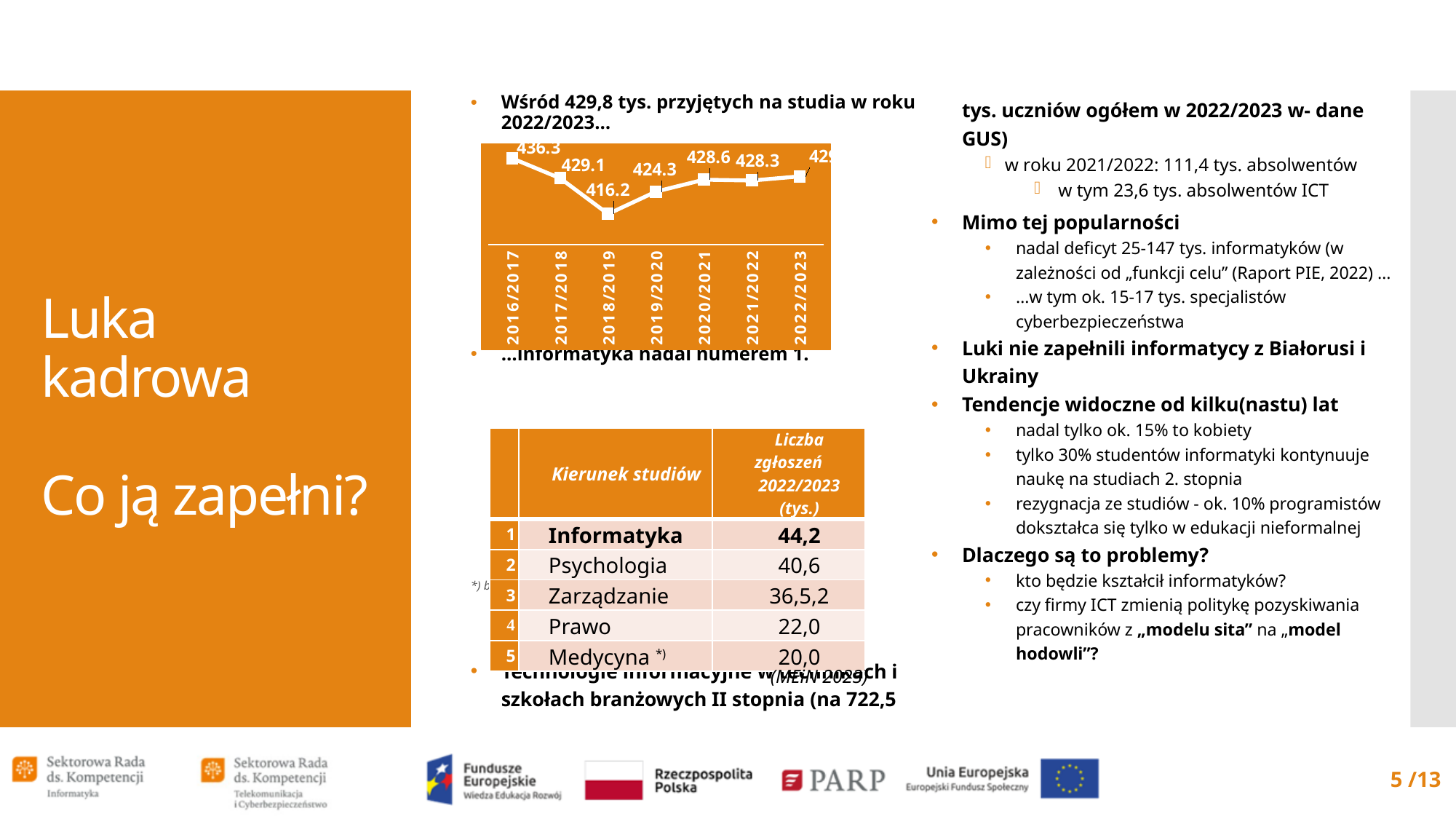
Which year has the lowest value in the line chart? 2018/2019 Do the values in the line chart rise or fall from 2016/2017 to 2018/2019? fall How many academic years are plotted on the x axis of the line chart? 7 What is the value for 2016/2017 in the line chart? 436.3 What is the difference between the values for 2017/2018 and 2019/2020 in the line chart? 4.8 Which is larger in the line chart: the value for 2017/2018 or the value for 2019/2020? 2017/2018 What is the value for 2019/2020 in the line chart? 424.3 Which year has the highest value in the line chart? 2016/2017 What type of chart is shown on the slide? line chart What is the value for 2018/2019 in the line chart? 416.2 What is the value for 2020/2021 in the line chart? 428.6 What is the difference between the values for 2016/2017 and 2018/2019 in the line chart? 20.1